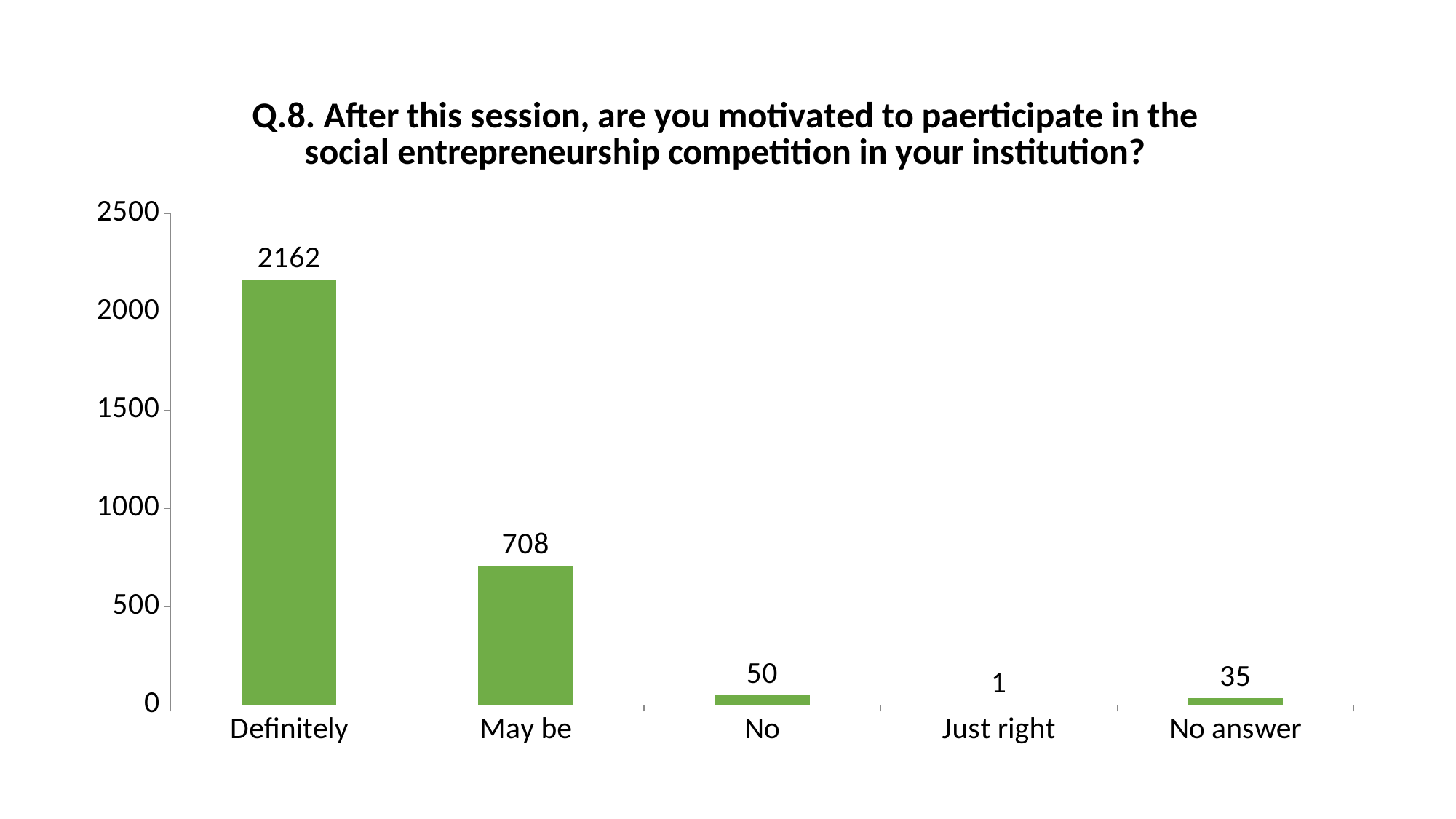
Is the value for May be greater or less than 1000? less What is the value for No answer? 35 Which category has the highest value? Definitely How many categories are shown on the x axis? 5 What is the difference between the values for Definitely and May be? 1454 What kind of chart is this? bar chart What is the value for Definitely? 2162 What is the value for May be? 708 What is the value for No? 50 Which is larger, the value for No or the value for No answer? No Which category has the lowest value? Just right What is the difference between the values for No and No answer? 15